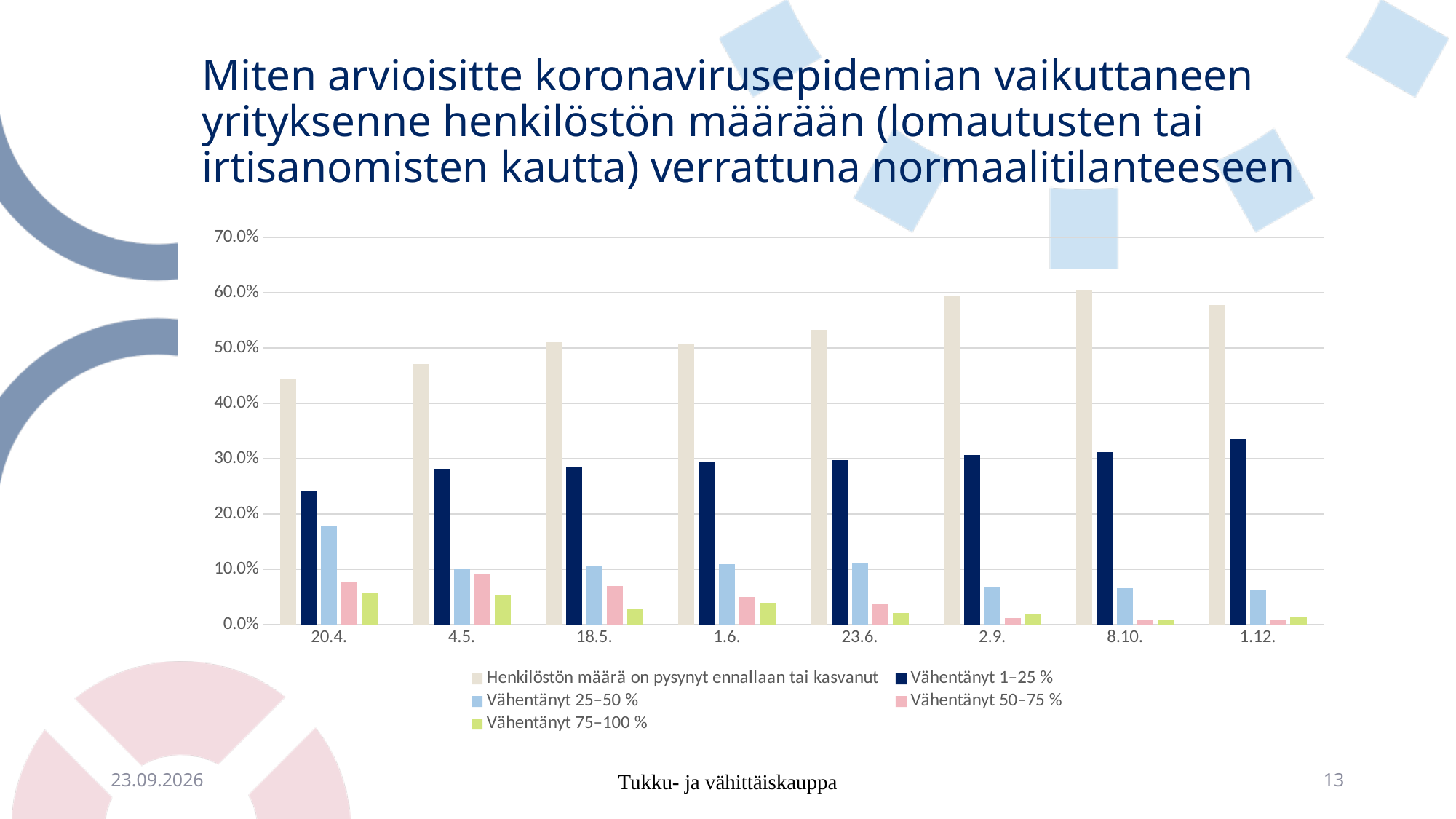
On which date is the value for 'Vähentänyt 1–25 %' highest? 1.12. Is the value for 'Vähentänyt 1–25 %' on 1.12. greater or less than 30.0%? greater Which is larger on 4.5.: 'Vähentänyt 25–50 %' or 'Vähentänyt 75–100 %'? Vähentänyt 25–50 % On which date is the value for 'Henkilöstön määrä on pysynyt ennallaan tai kasvanut' highest? 8.10. How many series does the legend list? 5 Is the value for 'Vähentänyt 25–50 %' on 20.4. greater or less than 20.0%? less On which date is the value for 'Vähentänyt 25–50 %' highest? 20.4. On which date is the value for 'Henkilöstön määrä on pysynyt ennallaan tai kasvanut' lowest? 20.4. How many dates are shown on the x axis? 8 Does the value for 'Vähentänyt 1–25 %' rise or fall from 20.4. to 1.12.? rise What kind of chart is shown on the slide? bar chart